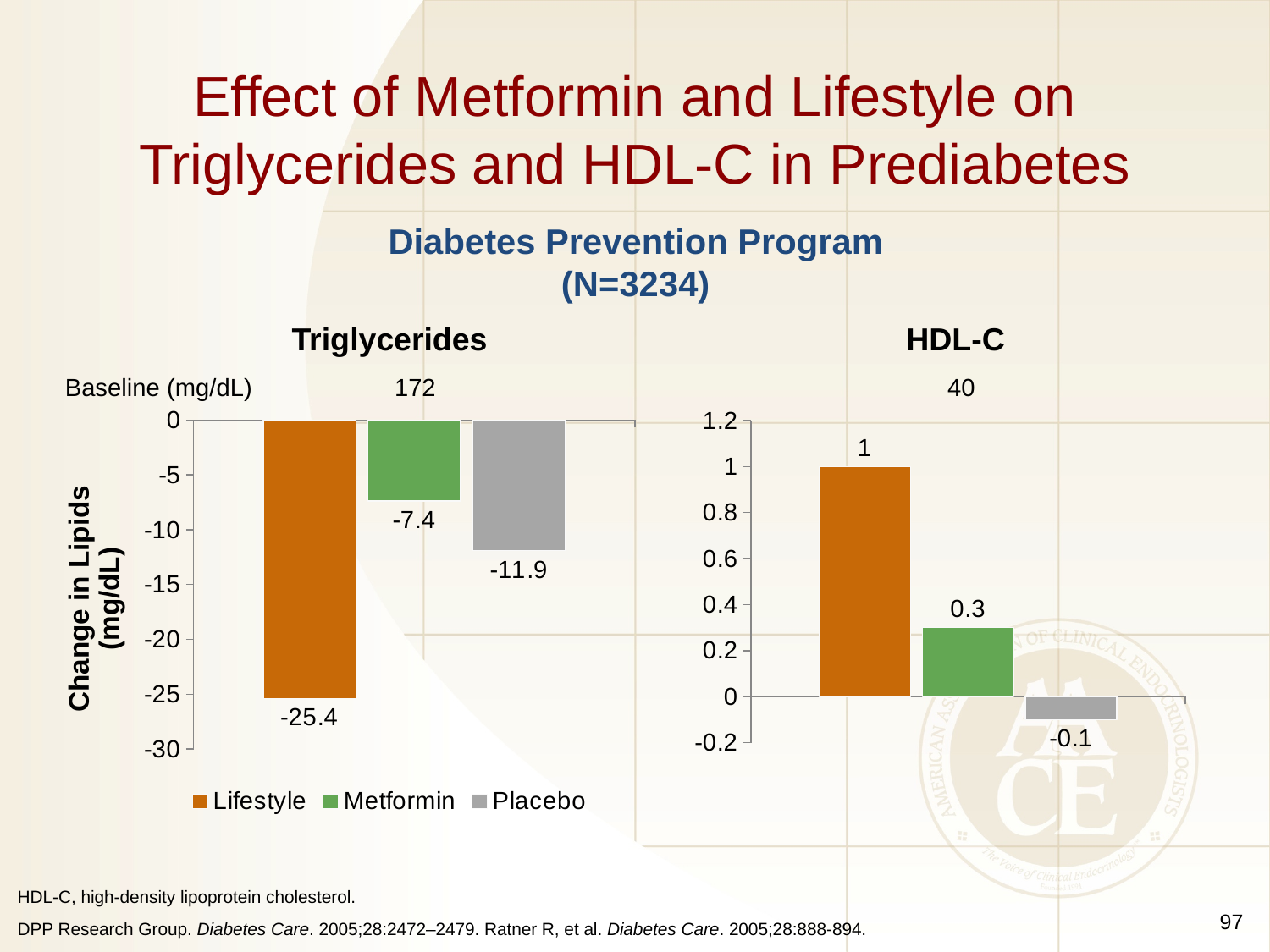
In the Triglycerides chart, is the decrease for Placebo larger or smaller than the decrease for Metformin? larger In the Triglycerides chart, what is the change in lipids for Placebo? -11.9 In the HDL-C chart, which group has the lowest value? Placebo In the HDL-C chart, what is the change in lipids for Placebo? -0.1 In the Triglycerides chart, which group shows the largest decrease? Lifestyle In the HDL-C chart, what is the difference between the Lifestyle and Metformin values? 0.7 What kind of chart is used to show the Triglycerides data? bar chart How many series does the legend list? 3 In the Triglycerides chart, what is the change in lipids for Metformin? -7.4 In the Triglycerides chart, what is the change in lipids for Lifestyle? -25.4 In the HDL-C chart, what is the change in lipids for Lifestyle? 1 In the Triglycerides chart, what is the difference between the Lifestyle and Placebo values? 13.5